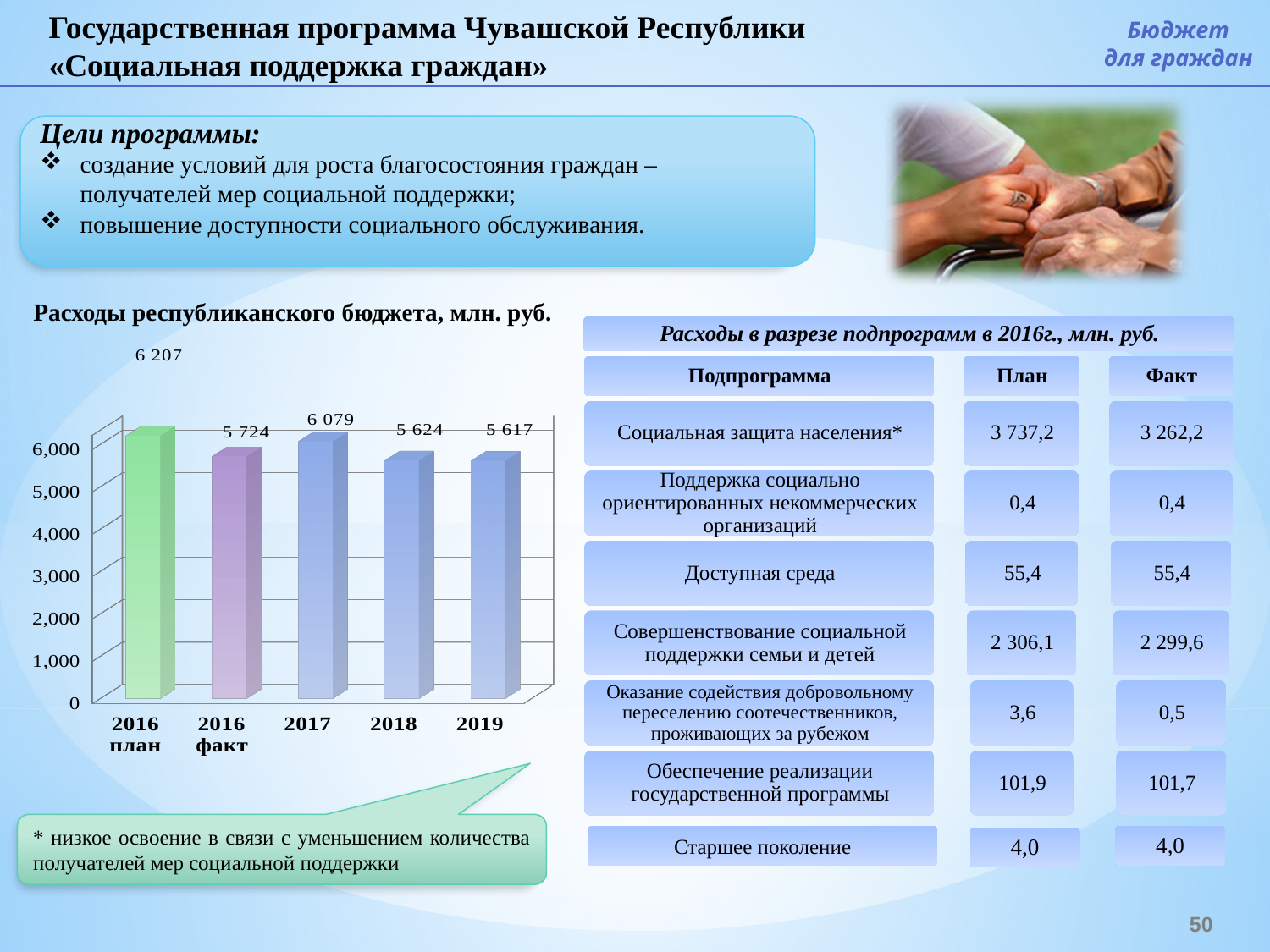
Which category has the lowest value in the chart? 2019 What is the value for 2016 факт in the chart? 5 724 What is the difference between the 2016 план and 2016 факт values? 483 Which is larger, the value for 2017 or the value for 2018? 2017 Which category has the highest value in the chart? 2016 план Is the value for 2018 greater or less than 6,000? less How many bars are plotted in the chart? 5 What kind of chart is used to show the republican budget expenditures? bar chart Do the values rise or fall from 2017 to 2019? fall What is the value shown for 2019 in the chart? 5 617 What is the value for 2016 план in the chart 'Расходы республиканского бюджета, млн. руб.'? 6 207 What is the value shown for 2017 in the chart? 6 079